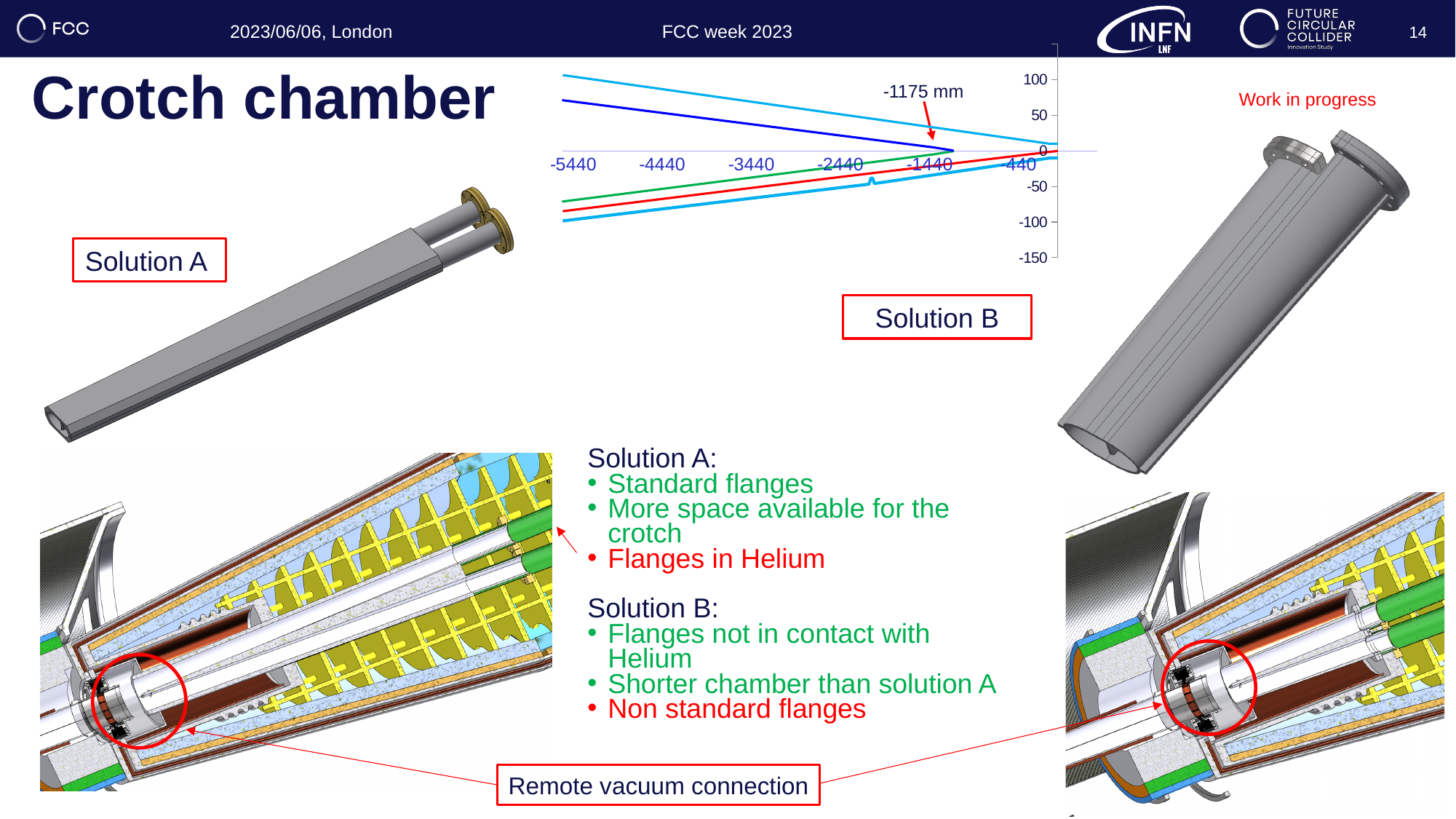
At x = -5440, which line has the higher value, the top light blue line or the dark blue line? the top light blue line How many tick labels are shown on the x axis of the chart? 6 What is the highest tick label shown on the y axis of the chart? 100 Is the value of the top light blue line at x = -5440 greater or less than 50? greater Is the value of the dark blue line at x = -5440 greater or less than 50? greater What value does the annotation with the red arrow on the chart indicate? -1175 mm At x = -5440, which line has the lower value, the green line or the bottom light blue line? the bottom light blue line What kind of chart is shown at the top of the slide? line chart Does the dark blue line on the chart rise or fall as x increases from -5440 toward 0? fall Does the red line on the chart rise or fall as x increases from -5440 toward 0? rise Is the value of the bottom light blue line at x = -5440 greater or less than -50? less What is the leftmost tick label on the x axis of the chart? -5440